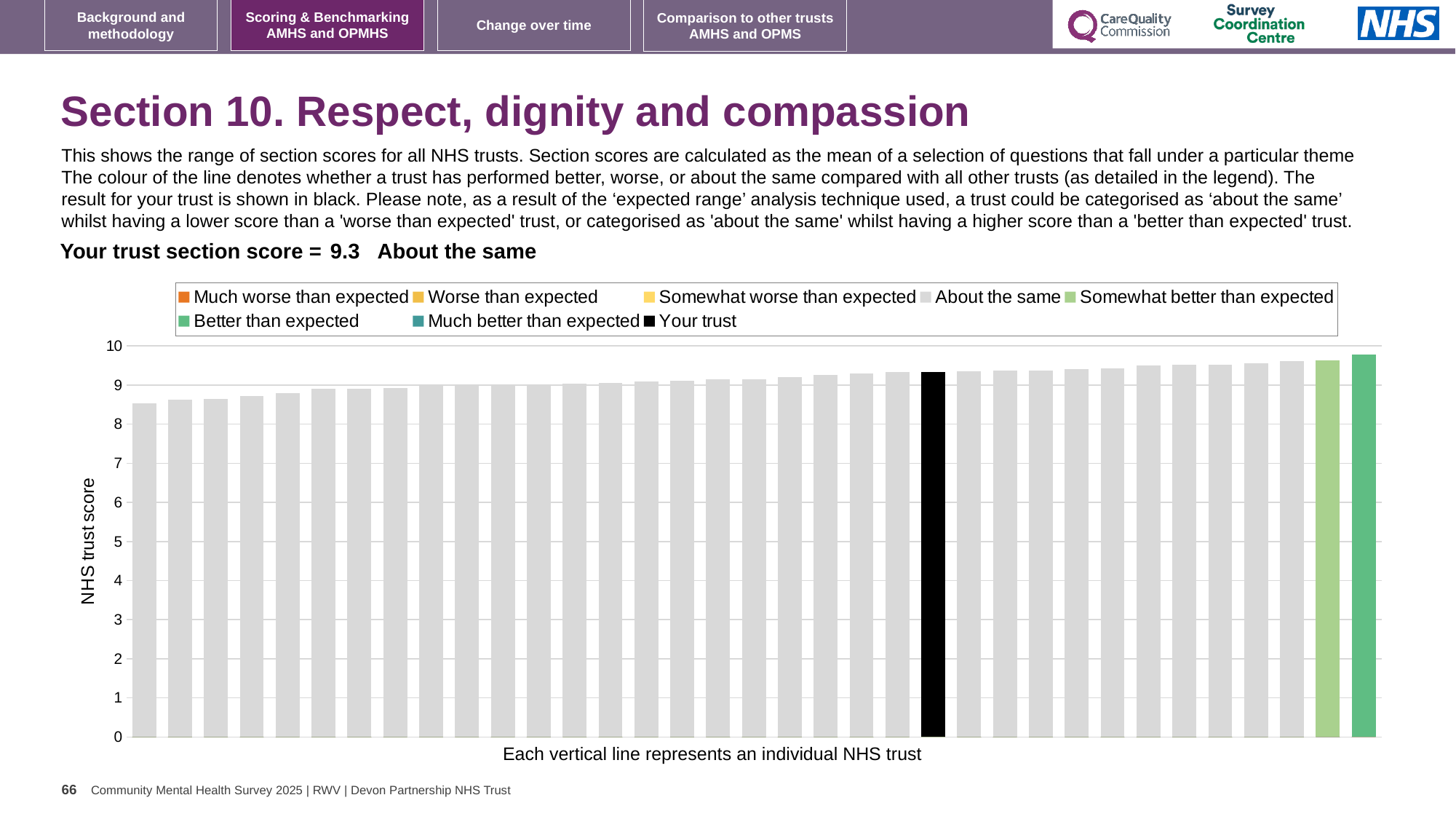
Do the bar values rise or fall from left to right along the x axis? rise How many bars are coloured green (somewhat better or better than expected)? 2 Which benchmarking category is your trust placed in for this section? About the same Is the value of the leftmost bar greater or less than 9? less Is the value for your trust (the black bar) greater or less than 9? greater Is the value of the rightmost bar greater or less than 9? greater What colour is the bar representing your trust? black Which bar is the highest: the black bar or the rightmost green bar? the rightmost green bar What is the label on the vertical axis? NHS trust score What kind of chart is shown on the slide? bar chart How many entries does the chart legend list? 8 What is the section score for your trust? 9.3